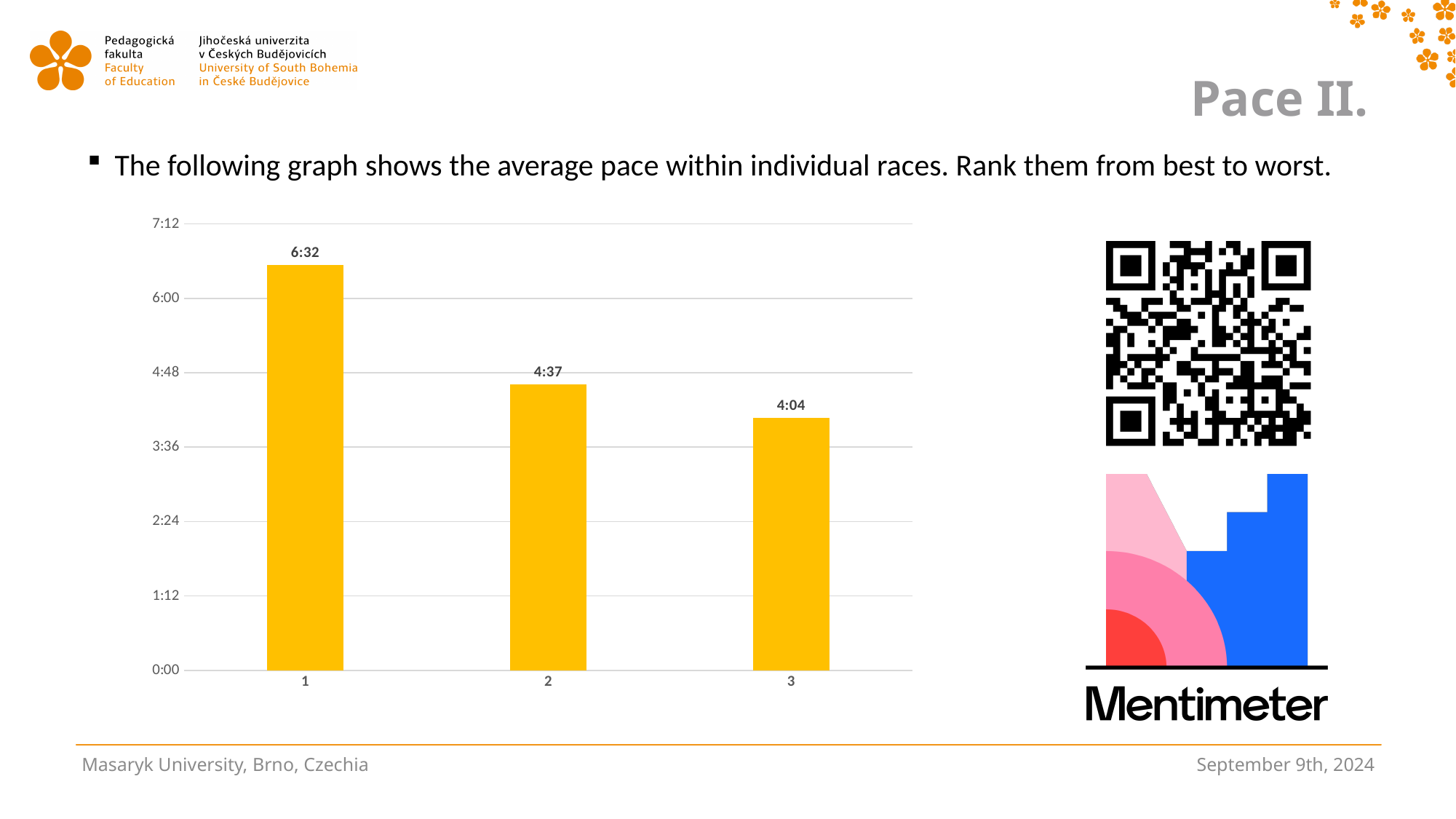
What kind of chart is shown on the slide? bar chart Do the bar values rise or fall from race 1 to race 3? fall What is the difference between the pace values for race 1 and race 2? 1:55 What is the average pace shown for race 1? 6:32 Which race has the highest bar in the chart? 1 What is the average pace shown for race 2? 4:37 How many races (bars) are shown in the chart? 3 Which race has the lowest bar in the chart? 3 Which has the larger value, race 2 or race 3? race 2 What is the difference between the pace values for race 2 and race 3? 0:33 What is the average pace shown for race 3? 4:04 Is the value for race 1 greater or less than 6:00? greater